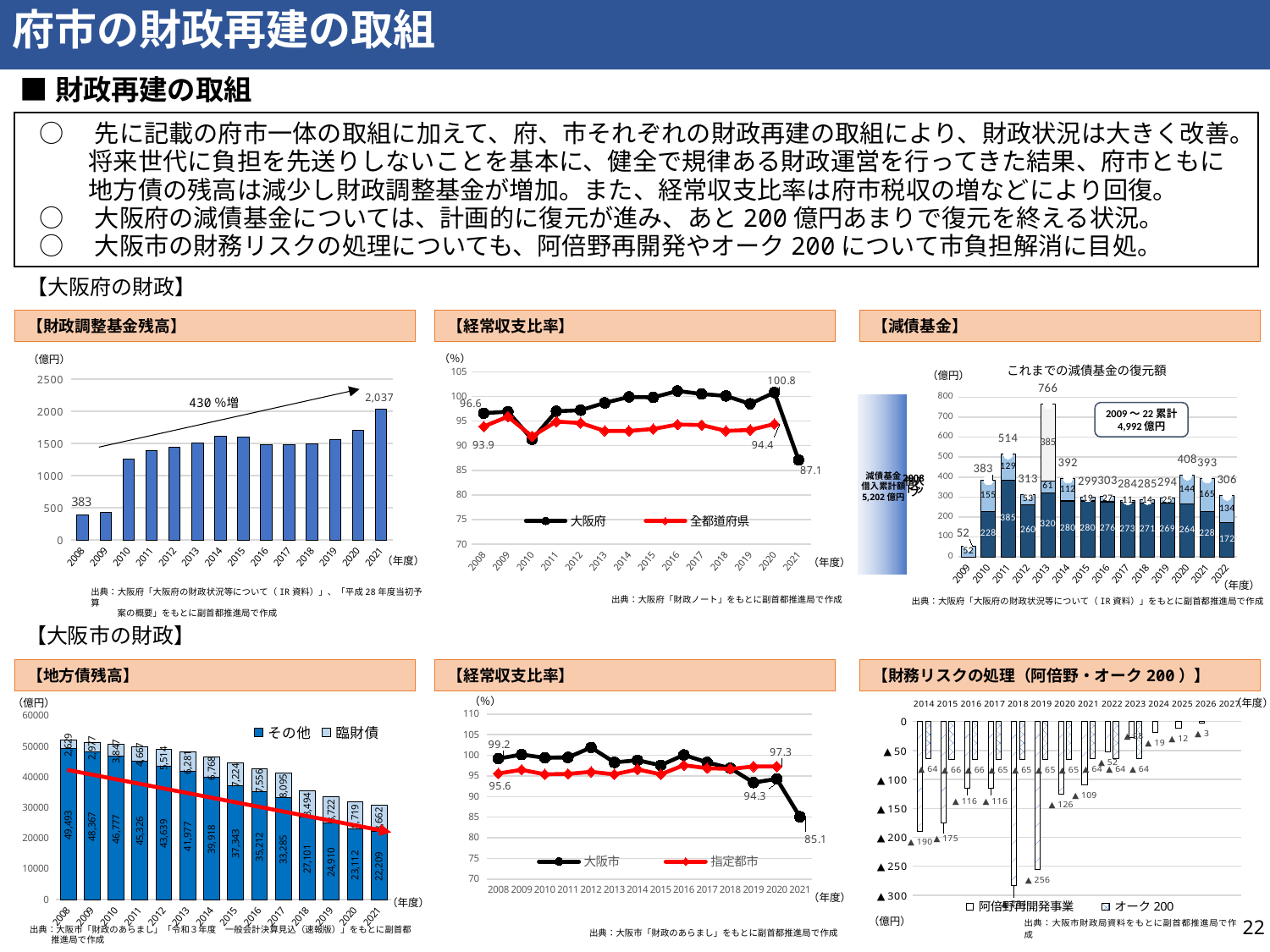
In the 【地方債残高】 chart for 大阪市, do the bars rise or fall from 2008 to 2021? fall In the 【経常収支比率】 chart for 大阪市, how many series does the legend list? 2 In the 【財政調整基金残高】 chart for 大阪府, what is the difference between the 2021 value and the 2008 value? 1,654 In the 【財政調整基金残高】 chart for 大阪府, how many years are plotted? 14 In the 【地方債残高】 chart for 大阪市, what is the その他 value for 2008? 49,493 In the 【経常収支比率】 chart for 大阪府, which series is higher in 2020, 大阪府 or 全都道府県? 大阪府 In the 【財政調整基金残高】 chart for 大阪府, what is the value for 2021? 2,037 In the 【減債基金】 chart, which year has the highest total? 2013 In the 【経常収支比率】 chart for 大阪府, what is the 全都道府県 value for 2008? 93.9 In the 【財政調整基金残高】 chart for 大阪府, what is the value for 2008? 383 In the 【経常収支比率】 chart for 大阪市, what is the 大阪市 value for 2021? 85.1 In the 【経常収支比率】 chart for 大阪府, what is the 大阪府 value for 2020? 100.8